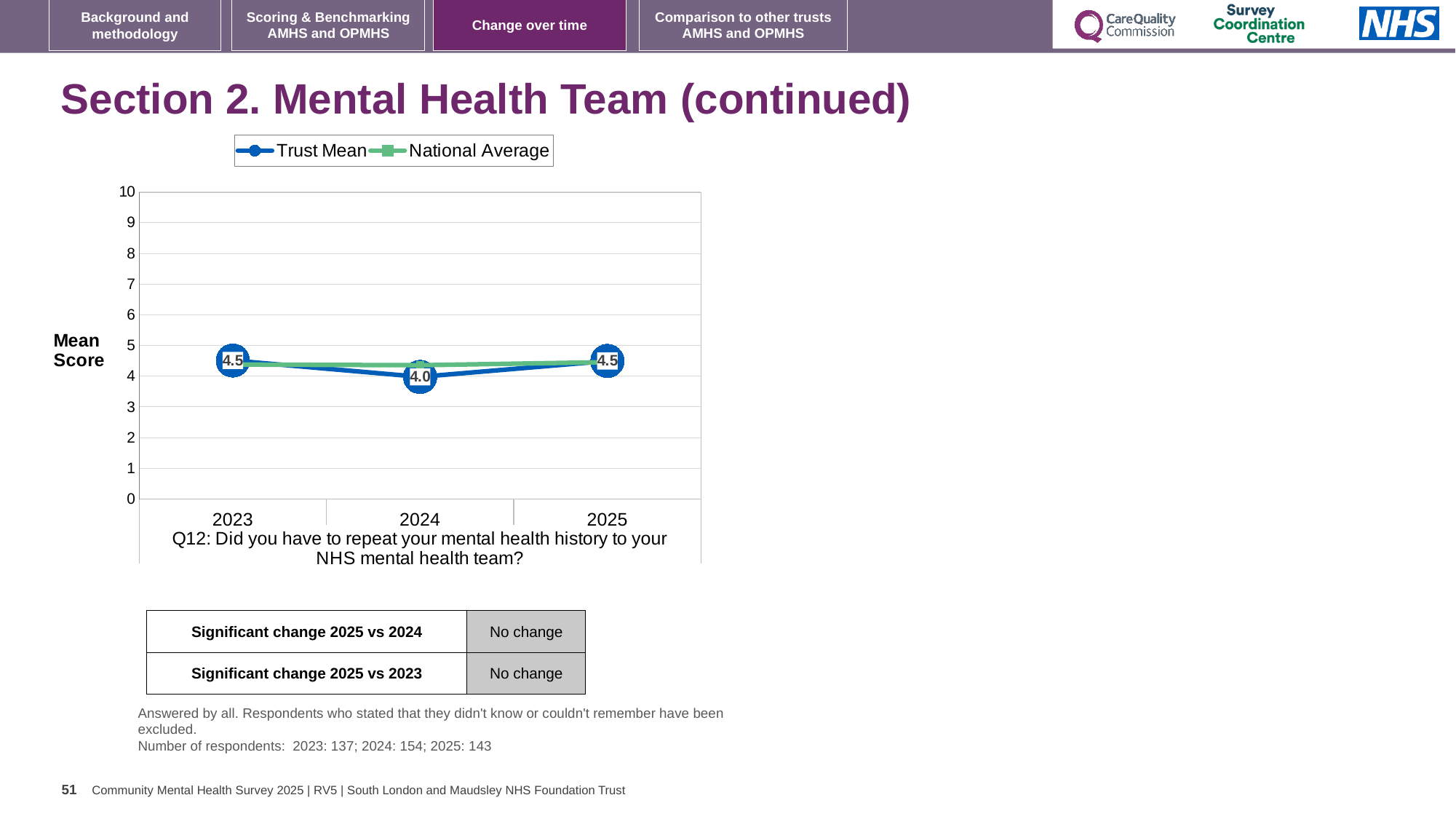
What is the Trust Mean value for 2025? 4.5 Does the Trust Mean rise or fall from 2024 to 2025? rise In which year is the Trust Mean lowest? 2024 What is the difference between the Trust Mean in 2023 and in 2024? 0.5 Is the National Average value for 2024 greater or less than 5? less Which is larger, the Trust Mean in 2024 or the Trust Mean in 2025? 2025 In 2024, which is higher, the Trust Mean or the National Average? National Average What kind of chart is shown on the slide? line chart How many years are plotted on the x axis? 3 What is the Trust Mean value for 2023? 4.5 How many series does the legend list? 2 What is the Trust Mean value for 2024? 4.0